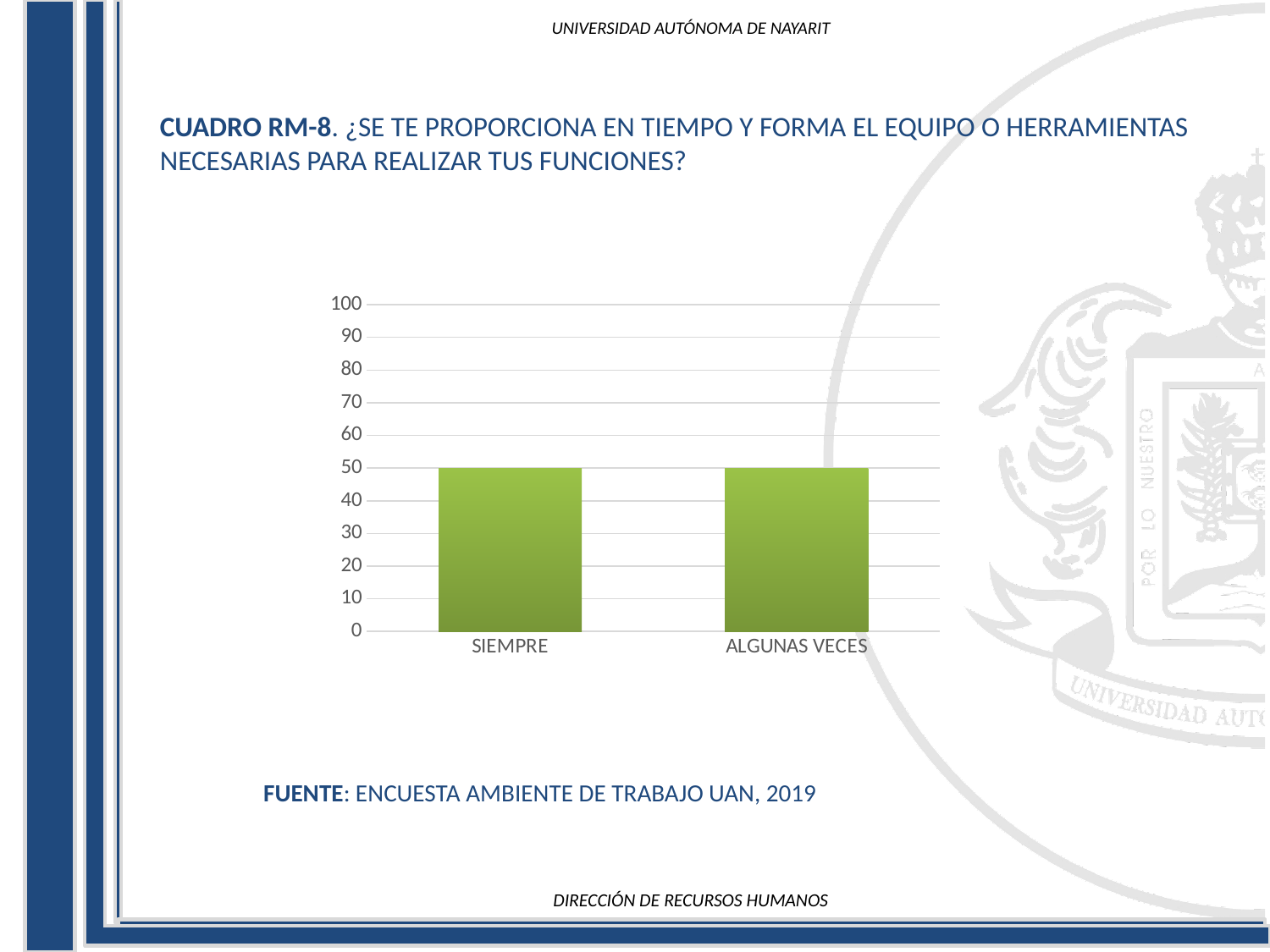
Is the value for ALGUNAS VECES greater or less than 20? greater What is the difference between the values for SIEMPRE and ALGUNAS VECES? 0 What are the two category labels on the x axis of the chart? SIEMPRE and ALGUNAS VECES Is the value for SIEMPRE greater or less than 80? less What is the maximum value shown on the y axis of the chart? 100 What is the value for SIEMPRE? 50 How many categories are shown on the x axis of the chart? 2 What is the value for ALGUNAS VECES? 50 What type of chart is shown on the slide? bar chart